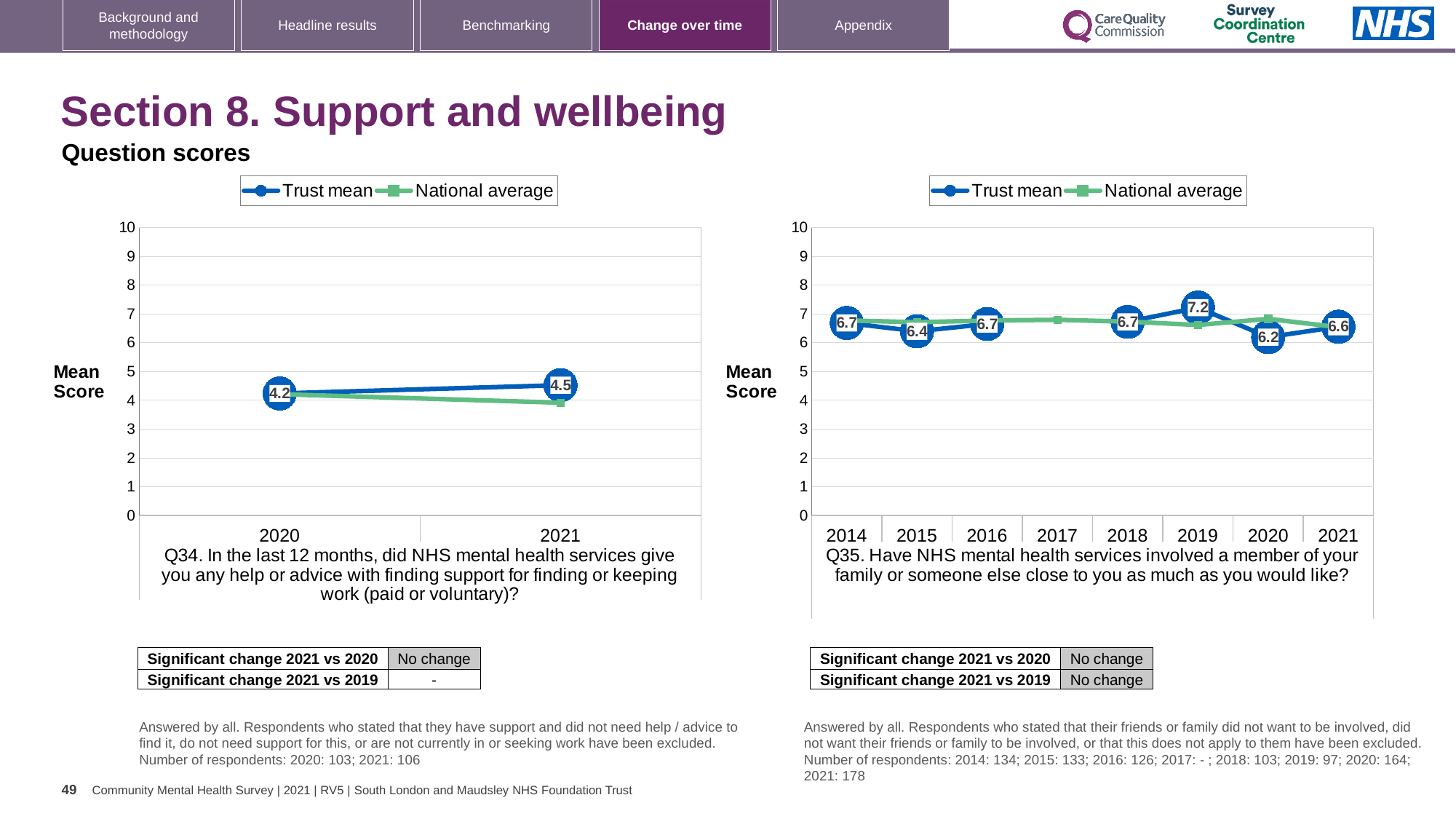
On the Q35 chart (right), what is the difference between the Trust mean in 2019 and in 2020? 1.0 On the Q35 chart (right), which year has the highest Trust mean score? 2019 What type of chart is used for Q34 on the left? Line chart On the Q35 chart (right), what is the Trust mean score for 2020? 6.2 On the Q34 chart (left), is the National average for 2021 greater or less than 5? less On the Q34 chart (left), by how much did the Trust mean change from 2020 to 2021? 0.3 On the Q34 chart (left), what is the Trust mean score for 2021? 4.5 On the Q35 chart (right), what is the Trust mean score for 2019? 7.2 On the Q35 chart (right), how many series does the legend list? 2 On the Q35 chart (right), how many years are shown on the x axis? 8 On the Q34 chart (left), what is the Trust mean score for 2020? 4.2 On the Q35 chart (right), which year has the lowest Trust mean score? 2020